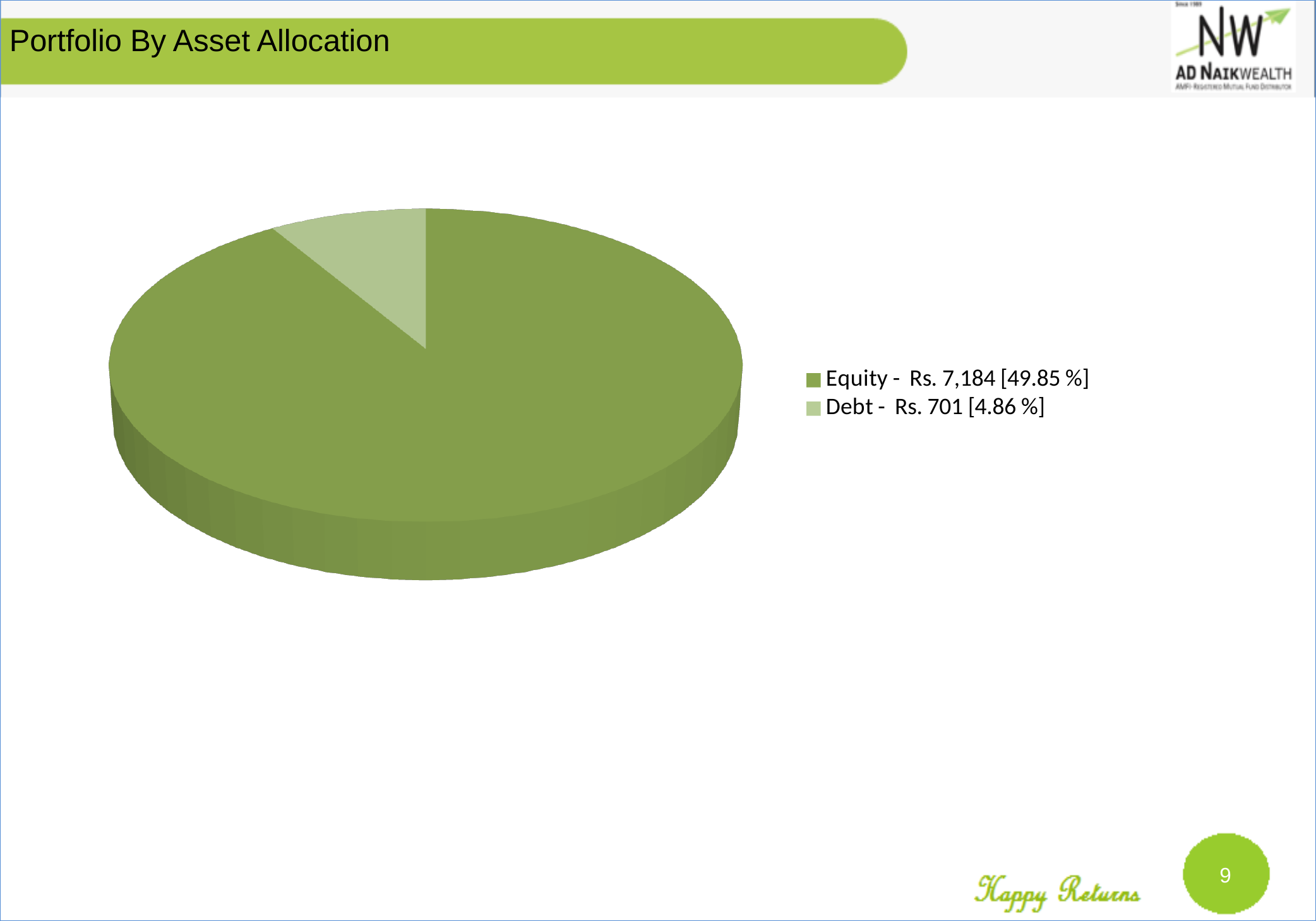
What is the title of the slide's chart? Portfolio By Asset Allocation What percentage share is shown for Debt in the legend? 4.86 % What is the difference between the Equity value and the Debt value? Rs. 6,483 Which asset class has the largest slice of the pie? Equity What is the value for Equity? Rs. 7,184 Which is larger, the value for Equity or the value for Debt? Equity How many entries does the legend list? 2 What type of chart is shown on the slide? Pie chart What is the value for Debt? Rs. 701 How many slices does the pie chart have? 2 Which asset class has the smallest slice of the pie? Debt What percentage share is shown for Equity in the legend? 49.85 %